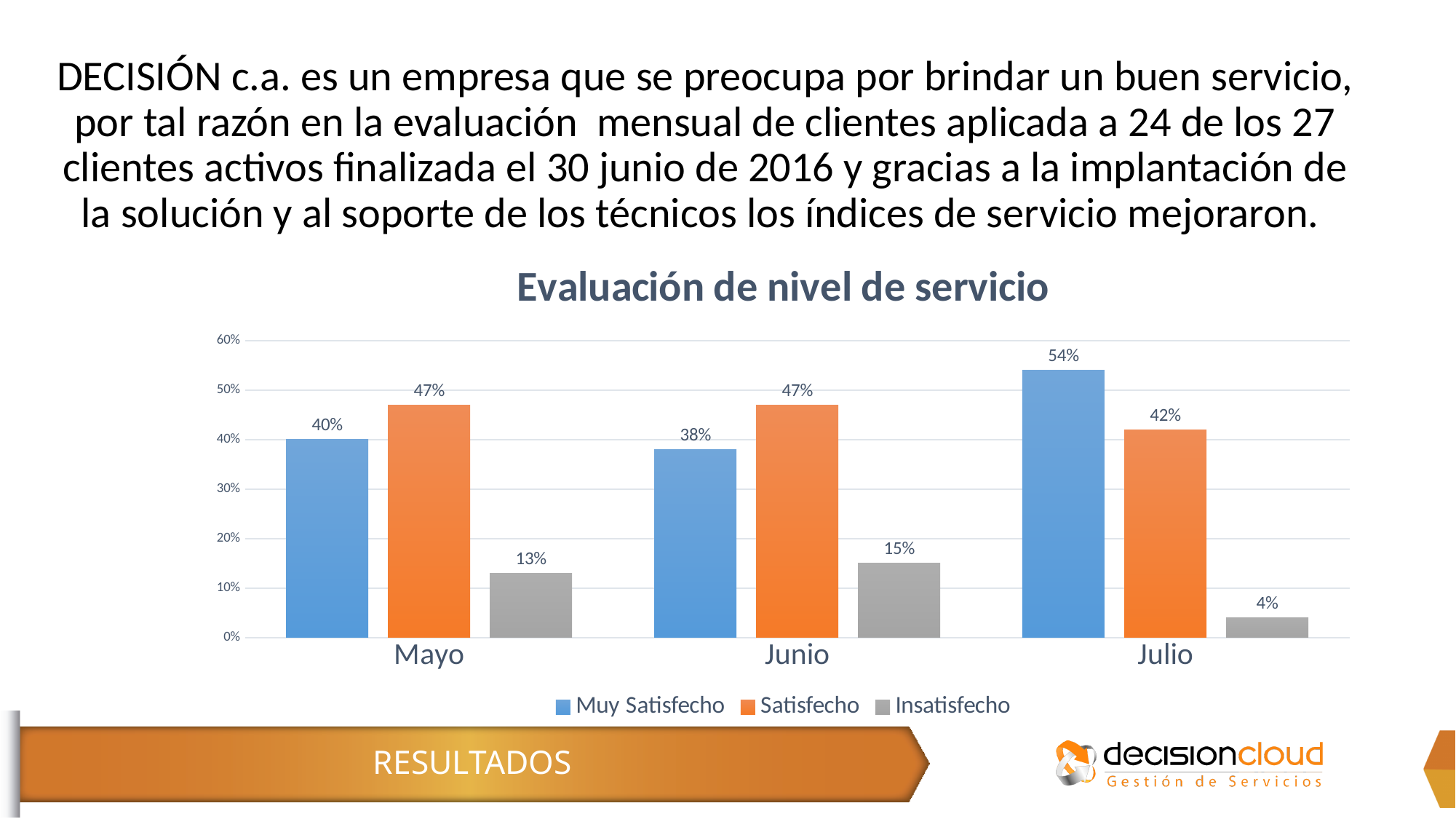
Which is larger in Mayo, Muy Satisfecho or Satisfecho? Satisfecho How many series does the legend list? 3 In which month is the Muy Satisfecho value highest? Julio What is the value for Muy Satisfecho in Julio? 54% What is the title of the chart? Evaluación de nivel de servicio How many months are shown on the x axis? 3 What is the difference between the Muy Satisfecho values for Julio and Junio? 16% What kind of chart is shown? Bar chart Is the value for Muy Satisfecho in Julio greater or less than 50%? greater In which month is the Insatisfecho value lowest? Julio What is the value for Satisfecho in Mayo? 47% What is the value for Insatisfecho in Junio? 15%